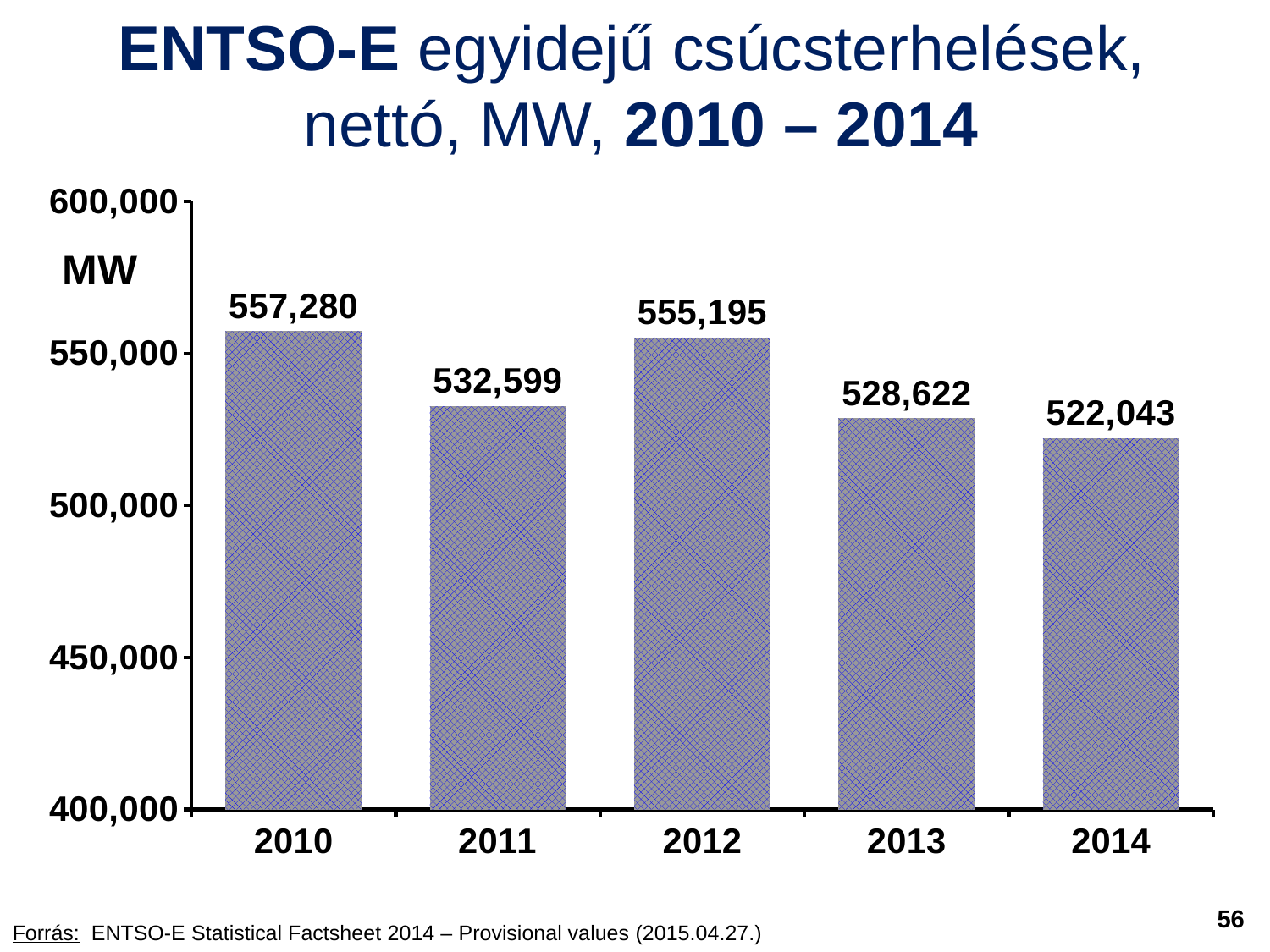
How many years are shown on the x axis? 5 What is the difference between the values for 2011 and 2013? 3,977 Which year has the lowest value? 2014 Is the value for 2013 greater or less than 550,000? less What is the value for 2010? 557,280 What unit is shown on the y axis label? MW What is the difference between the values for 2010 and 2014? 35,237 What is the value for 2012? 555,195 Which year has the highest value? 2010 What kind of chart is shown on the slide? bar chart Which is larger, the value for 2011 or the value for 2013? 2011 What is the value for 2014? 522,043